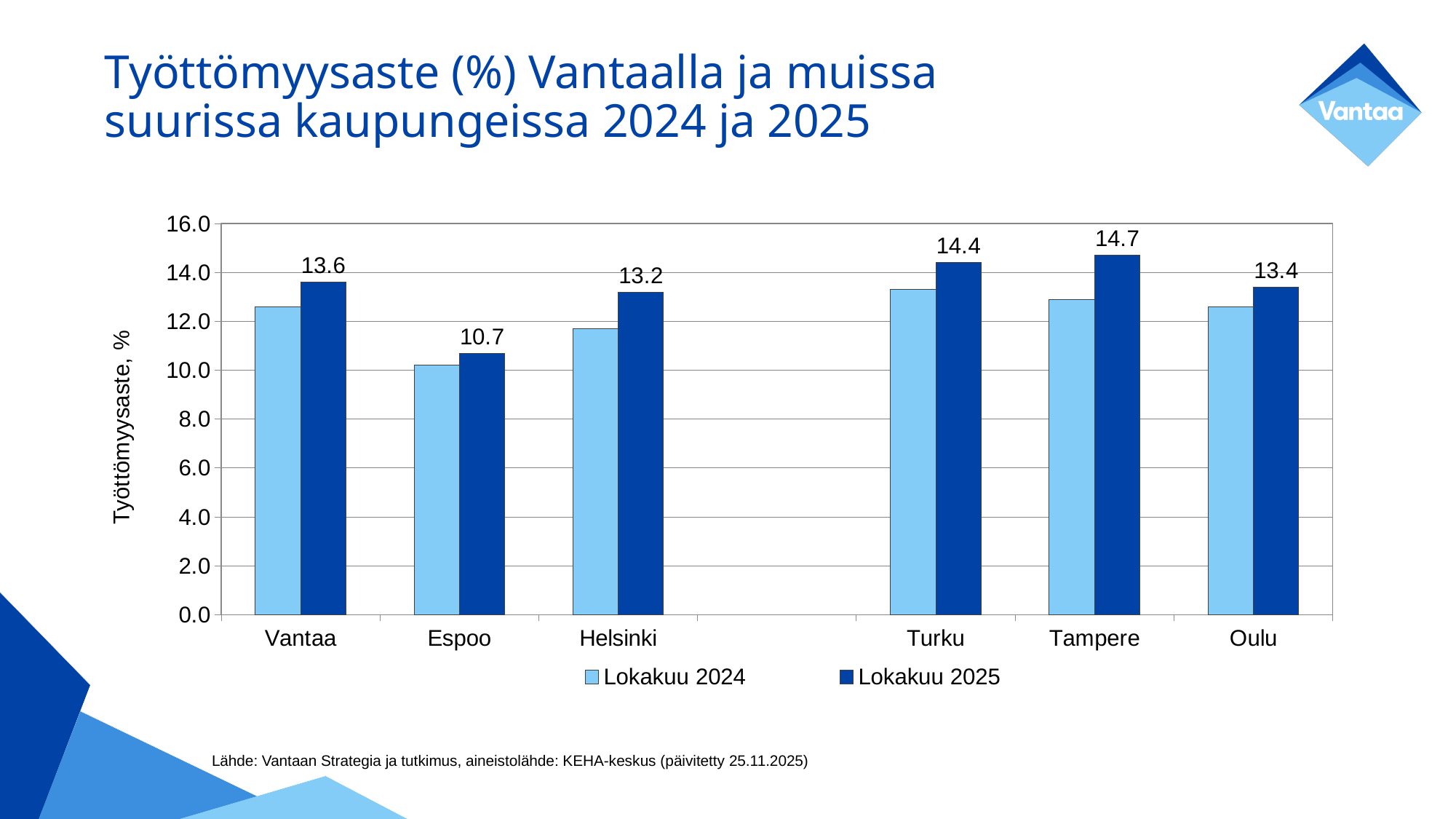
What is the value for Espoo in the Lokakuu 2025 series? 10.7 Which city has the highest Lokakuu 2025 unemployment rate? Tampere Is the Lokakuu 2024 value for Helsinki greater or less than 12.0? less What is the unemployment rate for Vantaa in Lokakuu 2025? 13.6 Which city has the lowest Lokakuu 2025 unemployment rate? Espoo How many cities are shown on the x axis? 6 Which is larger in Lokakuu 2025: Helsinki or Oulu? Oulu Is the Lokakuu 2024 value for Turku greater or less than 12.0? greater What is the difference between the Lokakuu 2025 values for Tampere and Espoo? 4.0 What kind of chart is shown on the slide? bar chart How many series does the legend list? 2 What is the Lokakuu 2025 value for Turku? 14.4